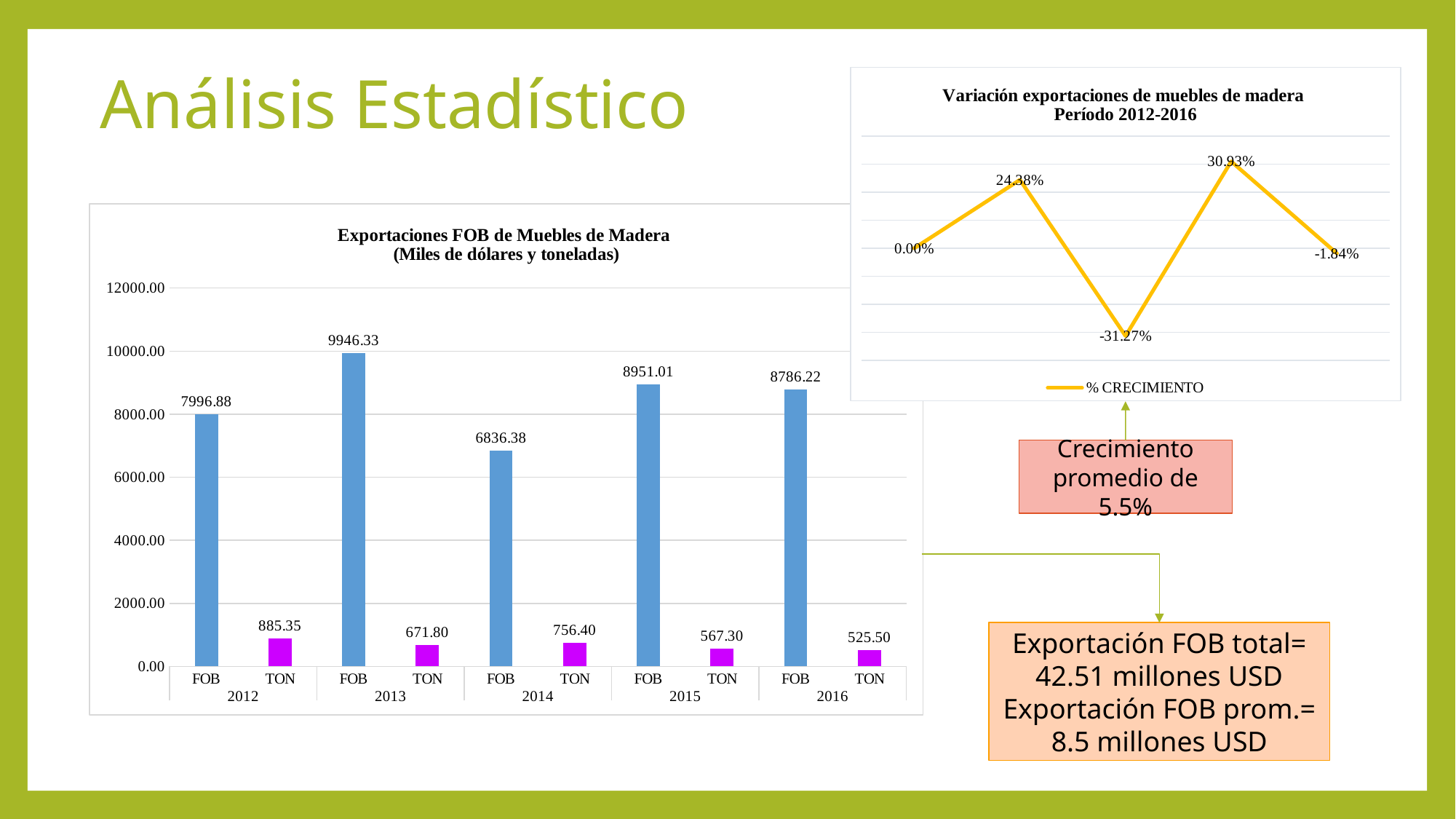
What series does the legend of the chart 'Variación exportaciones de muebles de madera Período 2012-2016' list? % CRECIMIENTO In the chart 'Exportaciones FOB de Muebles de Madera', is the TON value for 2012 larger than the TON value for 2014? Yes, 885.35 vs 756.40 In the chart 'Exportaciones FOB de Muebles de Madera', which year has the highest FOB value? 2013 In the chart 'Exportaciones FOB de Muebles de Madera', which year has the lowest TON value? 2016 In the chart 'Exportaciones FOB de Muebles de Madera', is the FOB value for 2014 greater or less than 8000.00? less What kind of chart is 'Exportaciones FOB de Muebles de Madera'? Bar chart How many years are shown on the x axis of the chart 'Exportaciones FOB de Muebles de Madera'? 5 In the chart 'Exportaciones FOB de Muebles de Madera', what is the TON value for 2015? 567.30 In the chart 'Exportaciones FOB de Muebles de Madera', what is the difference between the FOB values for 2013 and 2014? 3109.95 In the chart 'Variación exportaciones de muebles de madera Período 2012-2016', what is the lowest value of % CRECIMIENTO? -31.27% In the chart 'Variación exportaciones de muebles de madera Período 2012-2016', what is the highest value of % CRECIMIENTO? 30.93% In the chart 'Exportaciones FOB de Muebles de Madera', what is the FOB value for 2013? 9946.33